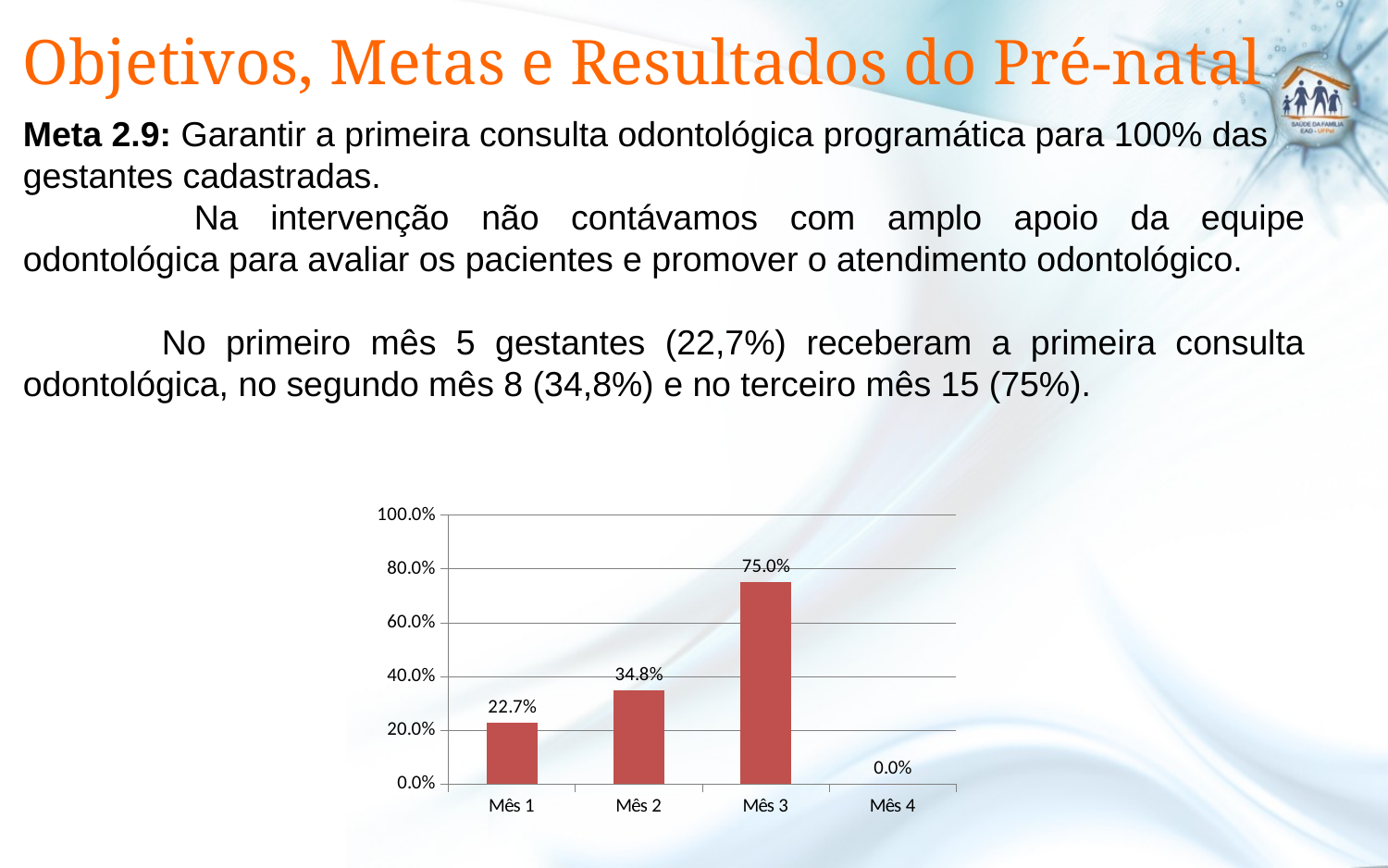
Is the value for Mês 3 greater or less than 60.0%? greater What kind of chart is shown on the slide? bar chart Which category has the lowest value? Mês 4 What is the value for Mês 1? 22.7% What is the value for Mês 4? 0.0% What is the value for Mês 2? 34.8% What is the difference between the values for Mês 3 and Mês 2? 40.2% Which is larger, the value for Mês 1 or the value for Mês 2? Mês 2 Which category has the highest value? Mês 3 Do the values rise or fall from Mês 1 to Mês 3? rise How many categories are shown on the x axis? 4 What is the value for Mês 3? 75.0%